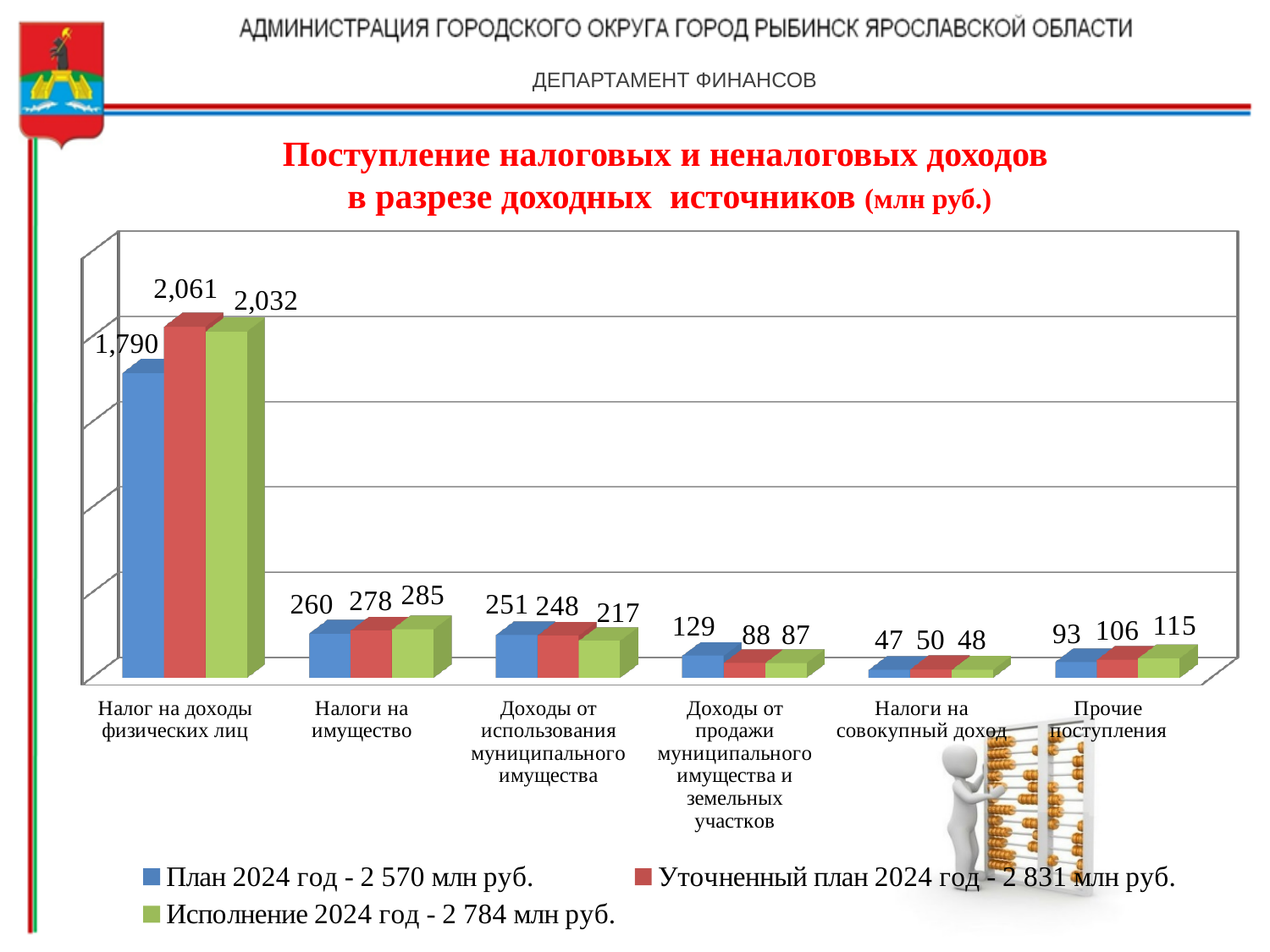
Which category has the lowest value for План 2024 год? Налоги на совокупный доход What is the value of Уточненный план 2024 год for Налог на доходы физических лиц? 2,061 According to the legend, what is the total for Уточненный план 2024 год? 2 831 млн руб. Which category has the highest value for Исполнение 2024 год? Налог на доходы физических лиц How many series does the legend list? 3 How many categories are shown on the x axis? 6 What is the difference between План 2024 год and Исполнение 2024 год for Прочие поступления? 22 What kind of chart is shown on the slide? Bar chart What is the difference between Уточненный план 2024 год and Исполнение 2024 год for Налог на доходы физических лиц? 29 For Доходы от использования муниципального имущества, which is larger: План 2024 год or Исполнение 2024 год? План 2024 год What is the value of План 2024 год for Доходы от продажи муниципального имущества и земельных участков? 129 What is the value of Исполнение 2024 год for Налоги на имущество? 285